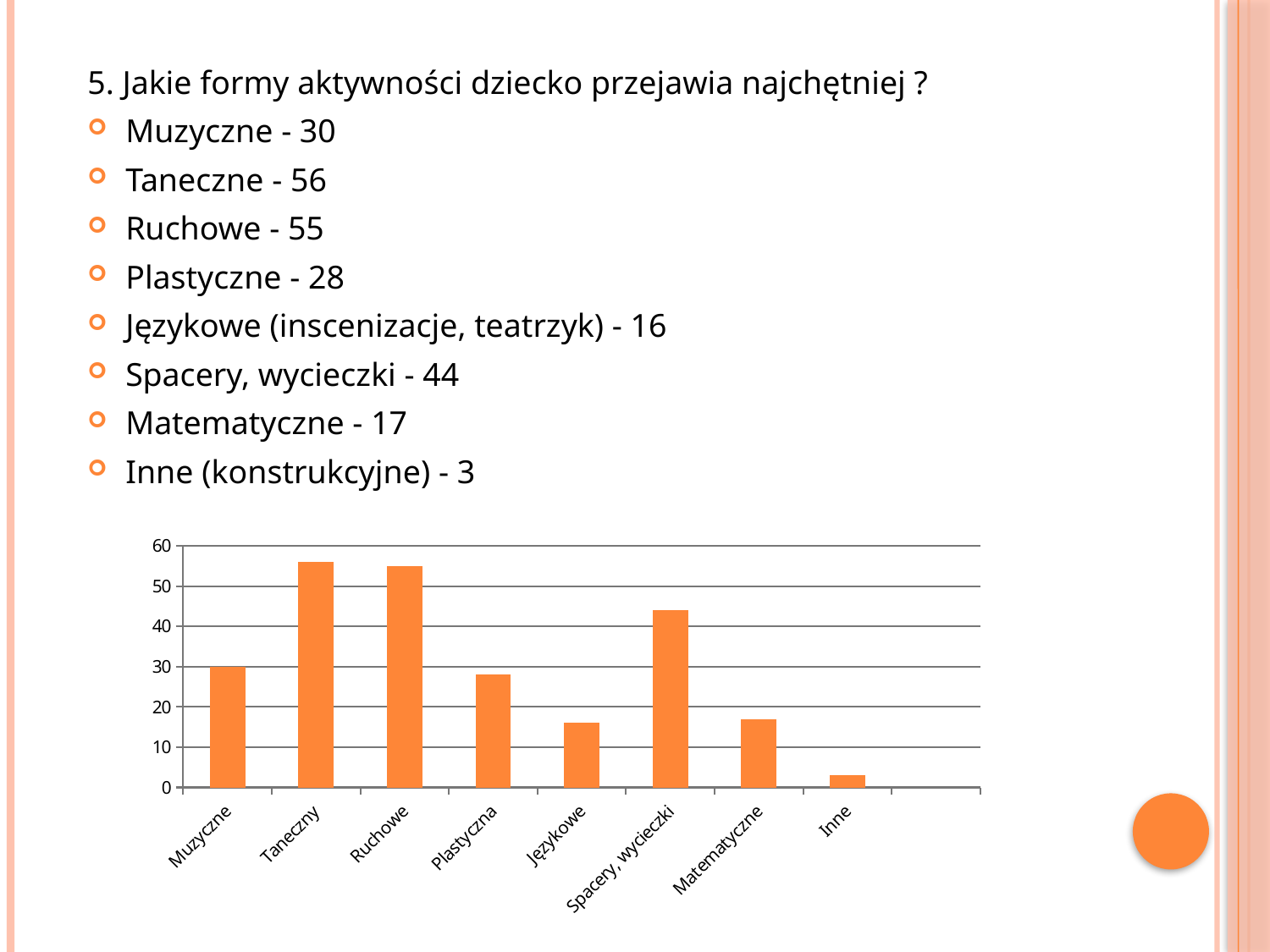
Which is larger, the value for Muzyczne or the value for Plastyczna? Muzyczne What kind of chart is shown on the slide? bar chart Which category has the highest value in the chart? Taneczny What is the value for Spacery, wycieczki in the chart? 44 What is the difference between the values for Ruchowe and Językowe? 39 What is the highest value shown on the y axis of the chart? 60 Which category has the lowest value in the chart? Inne What is the value for Muzyczne in the chart? 30 Is the value for Spacery, wycieczki greater or less than 40? greater What is the value for Inne in the chart? 3 How many categories are shown on the x axis of the chart? 8 Is the value for Matematyczne greater or less than 20? less